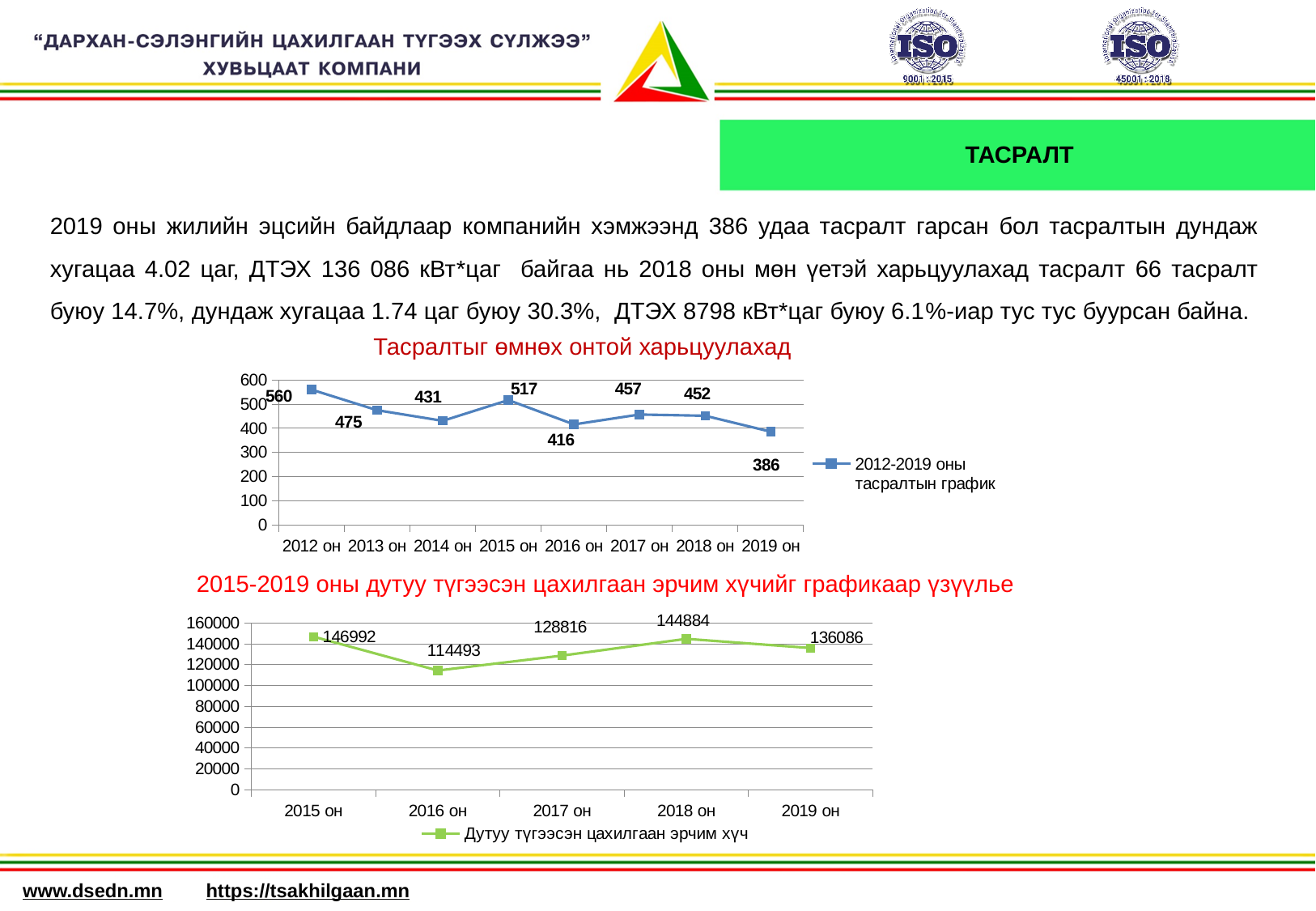
In the top chart (2012-2019 тасралтын график), which year has the lowest value? 2019 он In the top chart (2012-2019 тасралтын график), what is the value for 2015 он? 517 In the top chart (2012-2019 тасралтын график), how many years are plotted on the x axis? 8 In the top chart (2012-2019 тасралтын график), is the value for 2017 он greater or less than 400? greater In the bottom chart (Дутуу түгээсэн цахилгаан эрчим хүч), what is the value for 2018 он? 144884 What type of chart is the bottom chart (Дутуу түгээсэн цахилгаан эрчим хүч)? Line chart In the bottom chart (Дутуу түгээсэн цахилгаан эрчим хүч), what is the difference between the values for 2015 он and 2016 он? 32499 In the top chart (2012-2019 тасралтын график), what is the difference between the values for 2012 он and 2019 он? 174 What is the legend entry of the top chart? 2012-2019 оны тасралтын график In the bottom chart (Дутуу түгээсэн цахилгаан эрчим хүч), which is larger, the value for 2017 он or 2019 он? 2019 он In the bottom chart (Дутуу түгээсэн цахилгаан эрчим хүч), which year has the lowest value? 2016 он In the top chart (2012-2019 тасралтын график), which year has the highest value? 2012 он